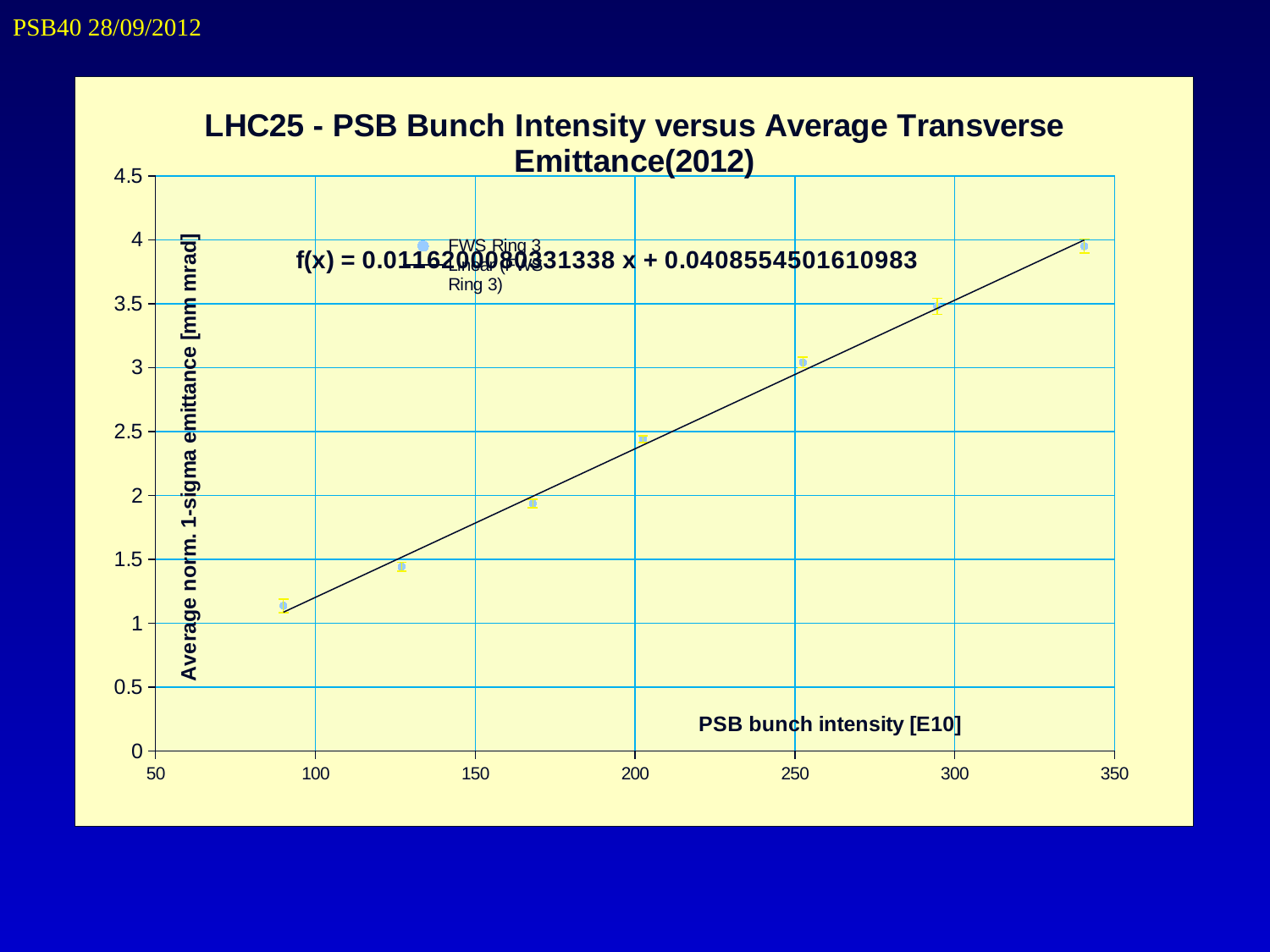
What is the title of the chart? LHC25 - PSB Bunch Intensity versus Average Transverse Emittance(2012) How many data points are plotted in the chart? 7 Is the emittance value of the rightmost data point (near 340 E10) greater or less than 3.5? greater What kind of chart is shown on the slide? Scatter chart with a linear trendline Is the emittance value of the data point near 170 E10 greater or less than 2? less What is the highest value shown on the y axis? 4.5 Is the emittance value of the leftmost data point (near 90 E10) greater or less than 1.5? less How many entries does the chart legend list? 2 What is the label of the x axis? PSB bunch intensity [E10] Does the average emittance rise or fall as PSB bunch intensity increases? Rises What is the intercept term shown in the fitted line equation f(x)? 0.0408554501610983